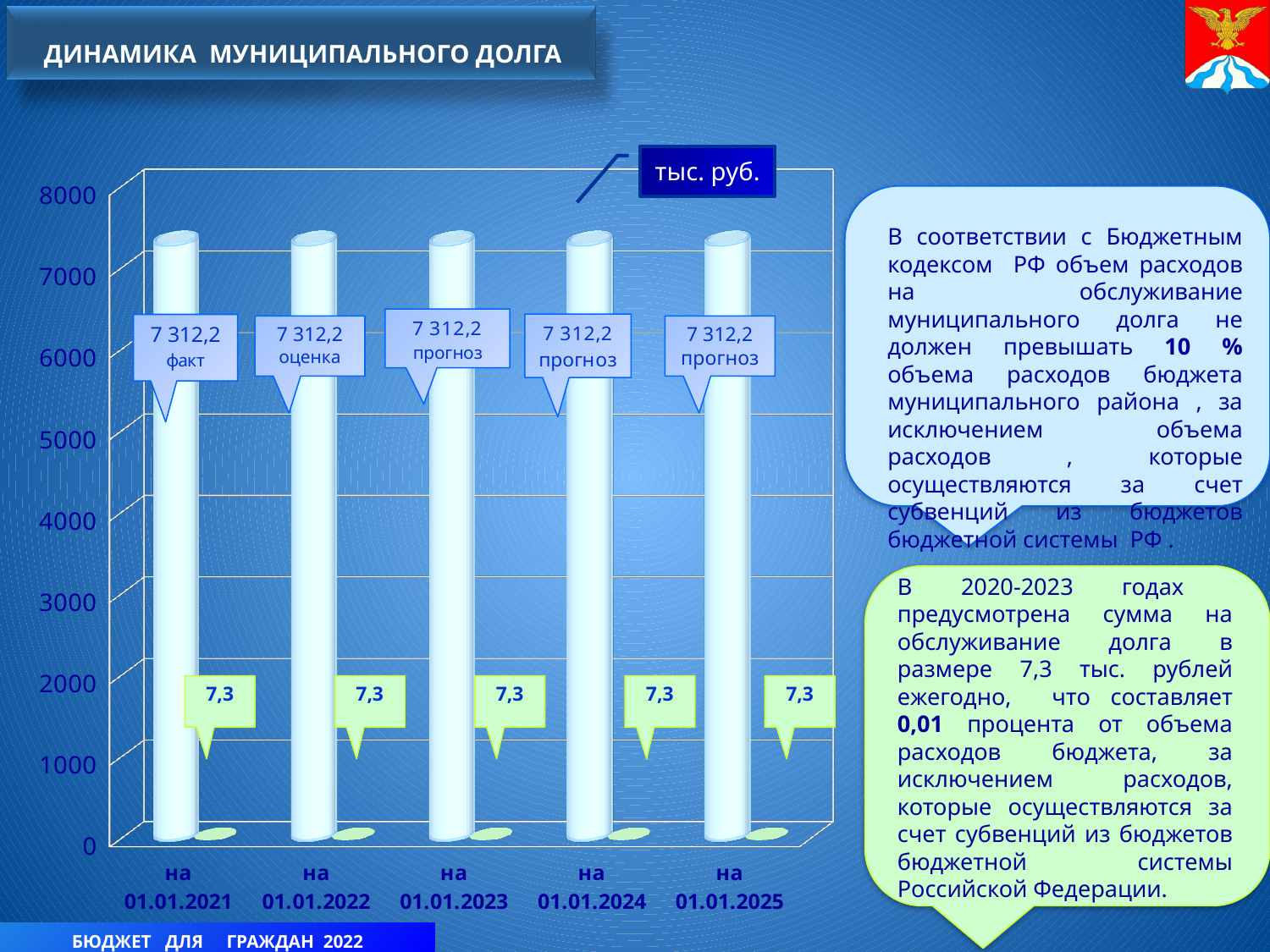
What unit of measurement is indicated on the chart? тыс. руб. What is the municipal debt value shown for 01.01.2025? 7 312,2 What kind of chart is shown on the slide? bar chart What is the municipal debt value shown for 01.01.2021? 7 312,2 What status label accompanies the value for 01.01.2022? оценка What status label accompanies the value for 01.01.2021? факт How many dates (categories) are plotted on the chart? 5 Is the municipal debt value for 01.01.2021 greater or less than 8000? less Do the municipal debt values rise, fall or stay the same from 01.01.2021 to 01.01.2025? stay the same Is the municipal debt value for 01.01.2023 greater or less than 7000? greater What is the difference between the municipal debt values for 01.01.2022 and 01.01.2024? 0 What is the debt servicing amount shown in the green label for 01.01.2023? 7,3